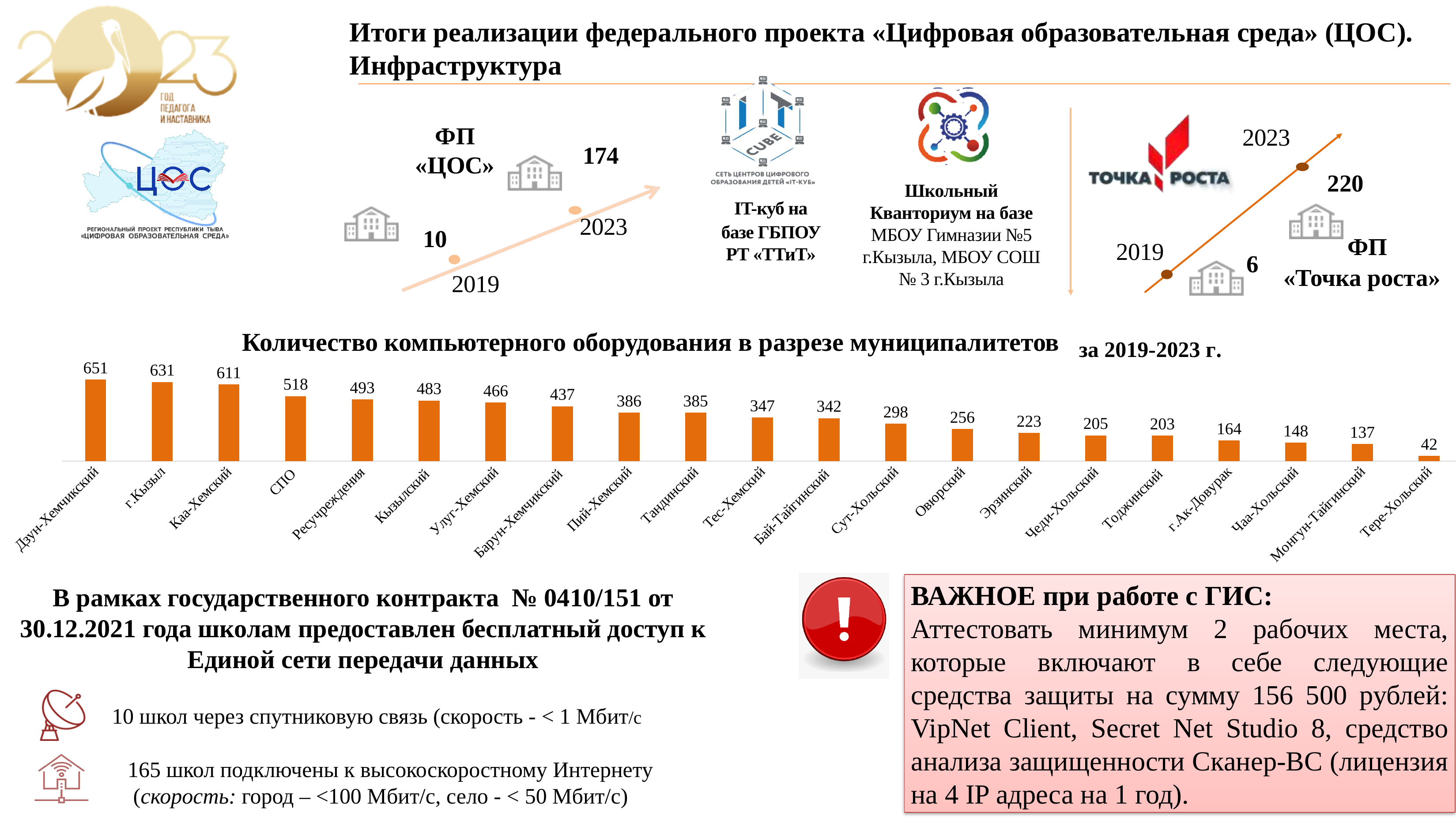
In the chart 'Количество компьютерного оборудования в разрезе муниципалитетов', what is the value for Тандинский? 385 How many categories are shown in the chart 'Количество компьютерного оборудования в разрезе муниципалитетов'? 21 What kind of chart is 'Количество компьютерного оборудования в разрезе муниципалитетов'? Bar chart In the chart 'Количество компьютерного оборудования в разрезе муниципалитетов', do the values rise or fall from left to right along the x axis? Fall In the chart 'Количество компьютерного оборудования в разрезе муниципалитетов', what is the difference between the values for СПО and Ресучреждения? 25 In the chart 'Количество компьютерного оборудования в разрезе муниципалитетов', what is the difference between the values for Дзун-Хемчикский and Тере-Хольский? 609 In the chart 'Количество компьютерного оборудования в разрезе муниципалитетов', which category has the highest value? Дзун-Хемчикский In the chart 'Количество компьютерного оборудования в разрезе муниципалитетов', what is the value for Чаа-Хольский? 148 In the chart 'Количество компьютерного оборудования в разрезе муниципалитетов', which is larger: the value for Каа-Хемский or the value for Кызылский? Каа-Хемский In the chart 'Количество компьютерного оборудования в разрезе муниципалитетов', what is the value for г.Кызыл? 631 In the chart 'Количество компьютерного оборудования в разрезе муниципалитетов', which category has the lowest value? Тере-Хольский In the chart 'Количество компьютерного оборудования в разрезе муниципалитетов', which is larger: the value for Овюрский or the value for Эрзинский? Овюрский